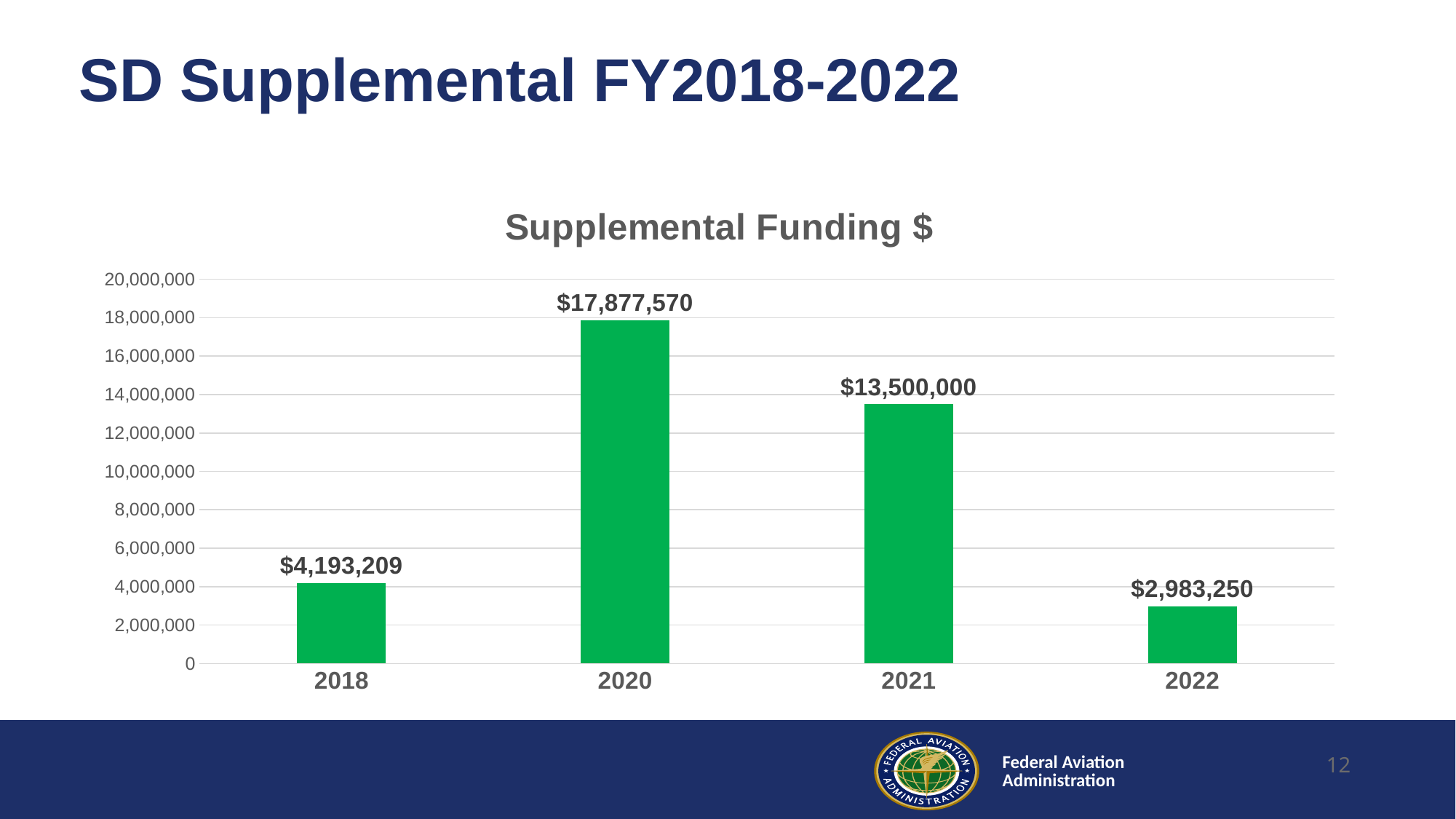
Is the supplemental funding for 2021 greater or less than 12,000,000? greater What kind of chart is shown on the slide? bar chart What is the title of the chart? Supplemental Funding $ Which year has the lowest supplemental funding? 2022 What is the supplemental funding value for 2020? $17,877,570 What is the supplemental funding value for 2018? $4,193,209 How many years are shown on the x axis of the chart? 4 What is the difference between the supplemental funding for 2018 and 2022? $1,209,959 What is the difference between the supplemental funding for 2020 and 2021? $4,377,570 What is the supplemental funding value for 2022? $2,983,250 Which year has larger supplemental funding, 2018 or 2021? 2021 Which year has the highest supplemental funding? 2020